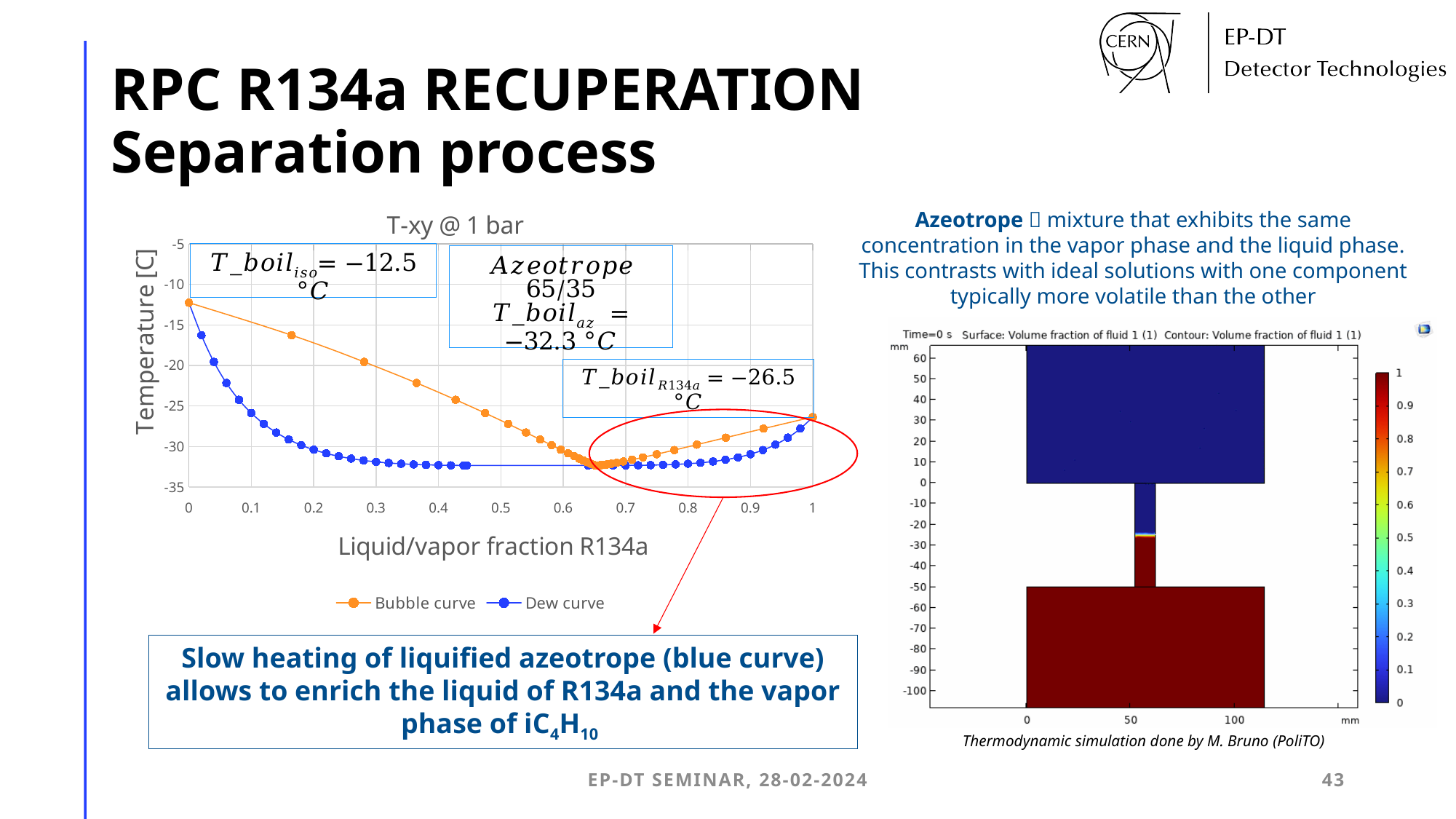
In the 'T-xy @ 1 bar' chart, what composition is stated for the azeotrope? 65/35 In the 'T-xy @ 1 bar' chart, does the Bubble curve rise or fall as the fraction goes from 0 to 0.6? fall In the 'T-xy @ 1 bar' chart, what boiling temperature is given for the azeotrope (T_boil_az)? −32.3 °C What is the x-axis label of the 'T-xy @ 1 bar' chart? Liquid/vapor fraction R134a In the 'T-xy @ 1 bar' chart, is the Dew curve value at a fraction of 0.3 greater or less than -30? less In the 'T-xy @ 1 bar' chart, what value is given for T_boil_iso? −12.5 °C In the 'T-xy @ 1 bar' chart, what value is given for T_boil_R134a? −26.5 °C What are the two series named in the legend of the 'T-xy @ 1 bar' chart? Bubble curve and Dew curve How many series does the legend of the 'T-xy @ 1 bar' chart list? 2 In the 'T-xy @ 1 bar' chart, at a fraction of 0.3, which curve has the higher temperature, the Bubble curve or the Dew curve? Bubble curve What kind of chart is the 'T-xy @ 1 bar' chart? line chart In the 'T-xy @ 1 bar' chart, is the Bubble curve value at a fraction of 0.3 greater or less than -25? greater